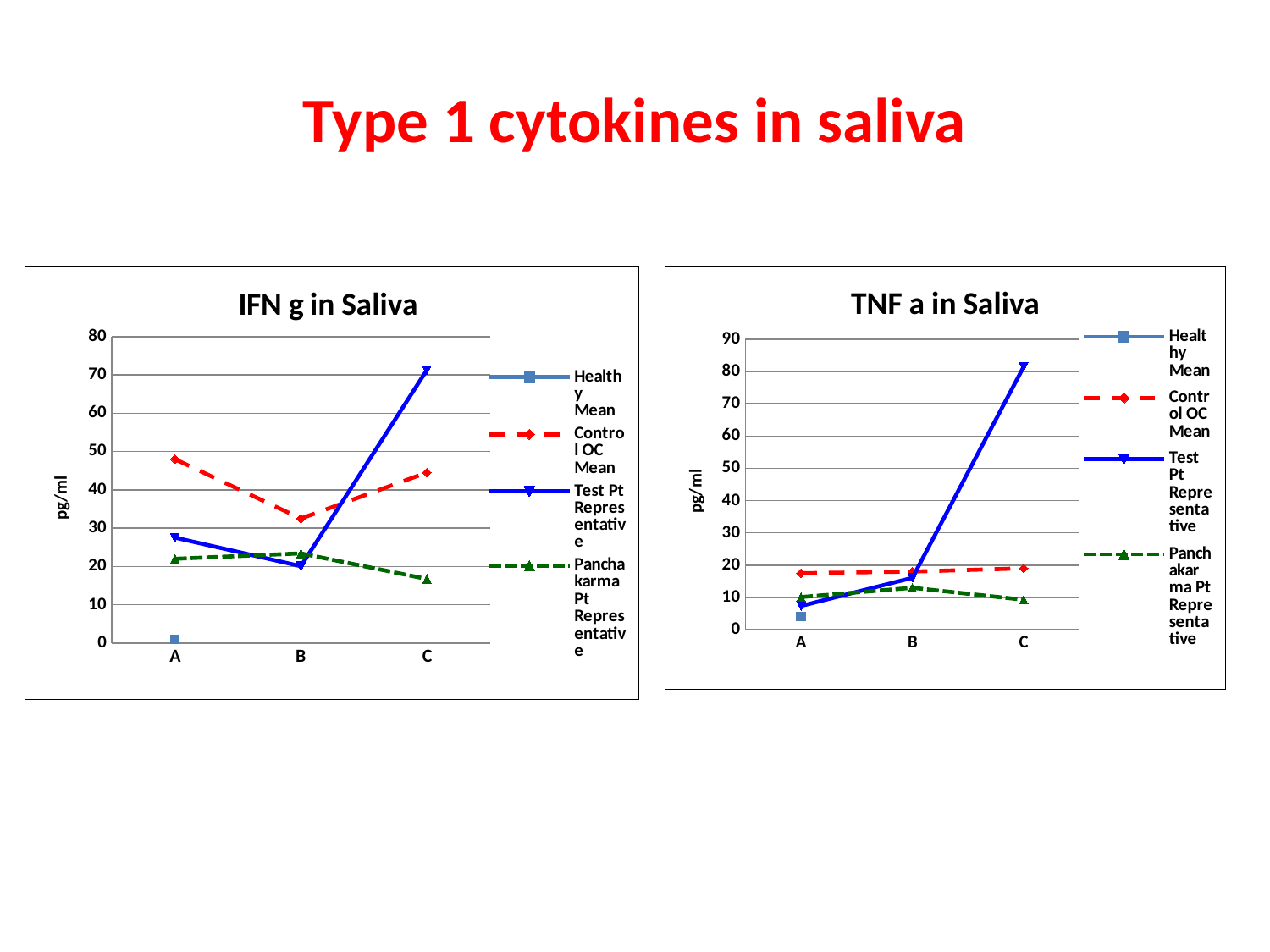
In the "IFN g in Saliva" chart, is the Test Pt Representative value at C greater or less than 60? greater In the "IFN g in Saliva" chart, at category A, which is larger: the Control OC Mean or the Test Pt Representative value? Control OC Mean How many series does the legend of the "TNF a in Saliva" chart list? 4 In the "TNF a in Saliva" chart, is the Test Pt Representative value at C greater or less than 70? greater In the "IFN g in Saliva" chart, is the Control OC Mean value at A greater or less than 40? greater In the "TNF a in Saliva" chart, does the Test Pt Representative series rise or fall from B to C? rise What is the y-axis label on the "TNF a in Saliva" chart? pg/ml How many categories are shown on the x axis of the "IFN g in Saliva" chart? 3 In the "IFN g in Saliva" chart, at which category does the Test Pt Representative series reach its highest value? C What kind of chart is the "IFN g in Saliva" chart? line chart